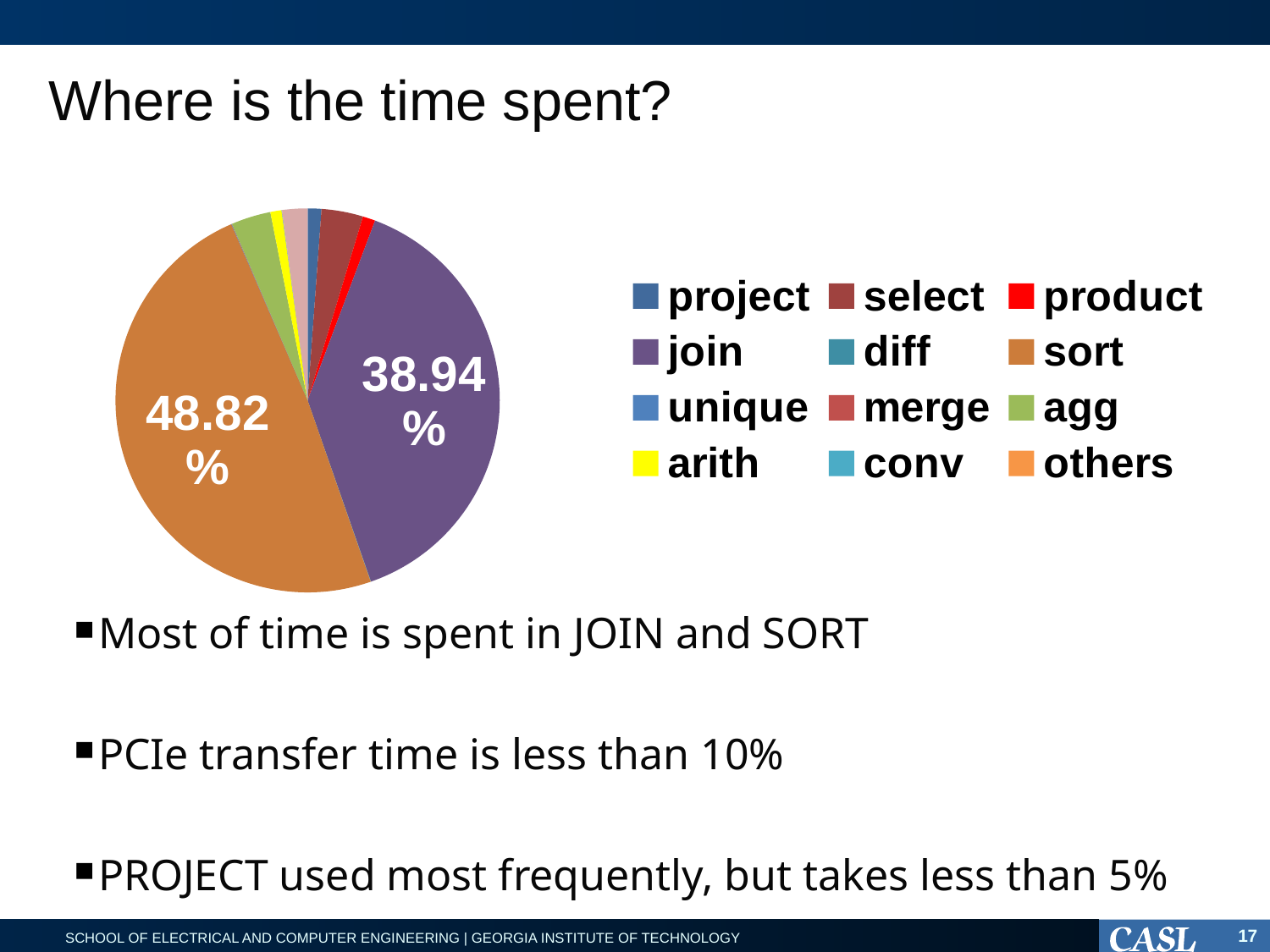
What type of chart is shown on the slide? pie chart Which is larger, the slice for select or the slice for product? select Which is larger, the share for sort or the share for join? sort What is the title of the slide containing the pie chart? Where is the time spent? What is the difference between the sort share and the join share? 9.88% What percentage of time is spent in join? 38.94% Which category takes the largest share of the pie? sort What percentage of time is spent in sort? 48.82% Which is larger, the slice for agg or the slice for arith? agg What colour is the sort slice in the pie chart? orange How many categories does the legend list? 12 What is the combined share of sort and join? 87.76%